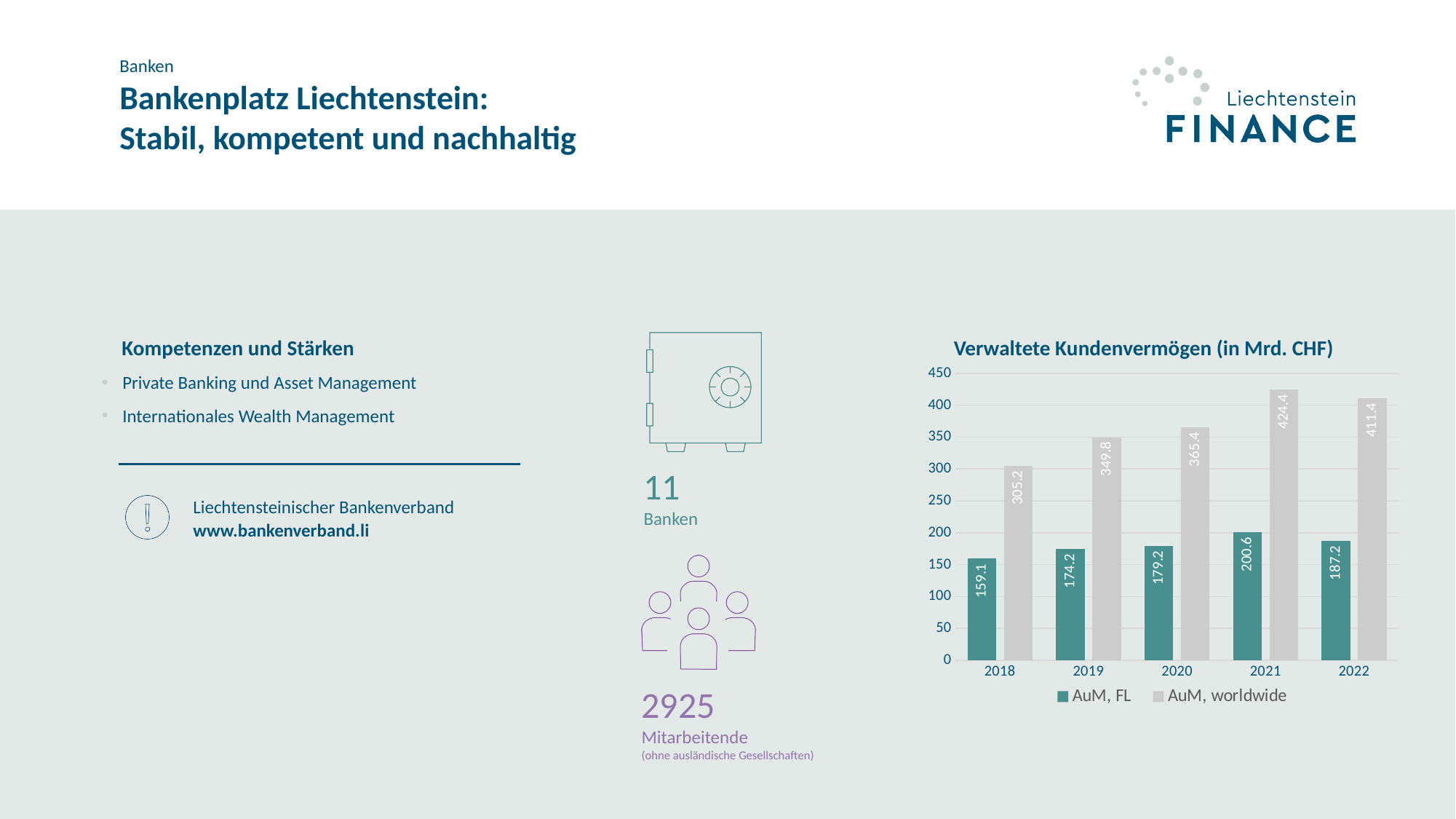
What is the value for AuM, FL in 2018? 159.1 In which year is AuM, worldwide highest? 2021 In which year is AuM, FL lowest? 2018 What is the value for AuM, worldwide in 2021? 424.4 What is the title of the chart? Verwaltete Kundenvermögen (in Mrd. CHF) What is the value for AuM, FL in 2022? 187.2 What kind of chart is shown on the slide? bar chart Is the value for AuM, worldwide in 2019 greater or less than 300? greater How many years are shown on the x axis of the chart? 5 Which is larger, AuM, FL in 2021 or AuM, FL in 2022? AuM, FL in 2021 What is the difference between AuM, worldwide and AuM, FL in 2020? 186.2 How many series does the chart legend list? 2